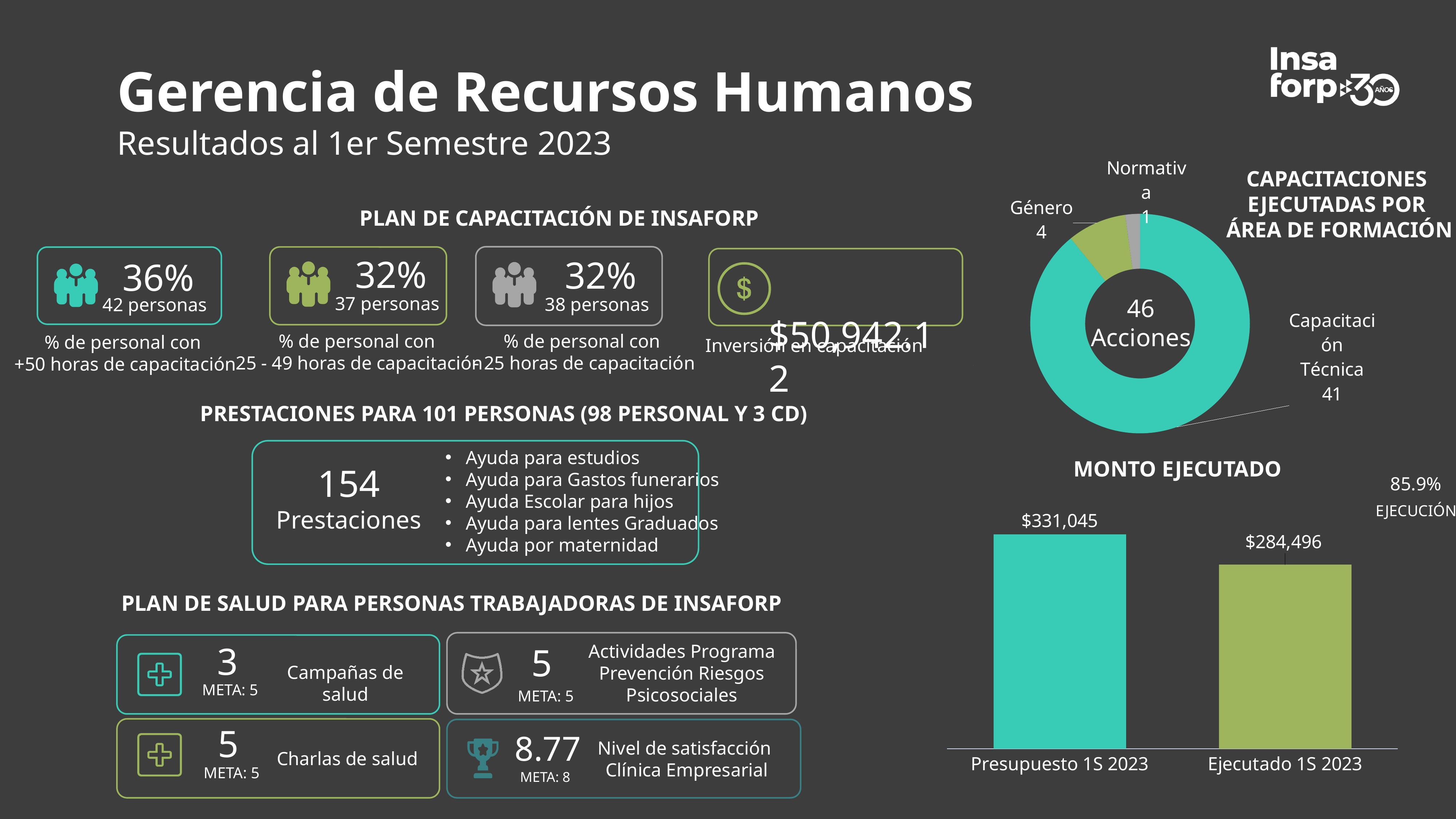
In the 'CAPACITACIONES EJECUTADAS POR ÁREA DE FORMACIÓN' chart, how many areas are shown? 3 What kind of chart is 'CAPACITACIONES EJECUTADAS POR ÁREA DE FORMACIÓN'? Donut (pie) chart In the 'MONTO EJECUTADO' chart, which is larger, Presupuesto 1S 2023 or Ejecutado 1S 2023? Presupuesto 1S 2023 In the 'MONTO EJECUTADO' chart, what is the value for Ejecutado 1S 2023? $284,496 In the 'CAPACITACIONES EJECUTADAS POR ÁREA DE FORMACIÓN' chart, which area has the most actions? Capacitación Técnica What kind of chart is 'MONTO EJECUTADO'? Bar chart In the 'CAPACITACIONES EJECUTADAS POR ÁREA DE FORMACIÓN' chart, which area has the fewest actions? Normativa In the 'CAPACITACIONES EJECUTADAS POR ÁREA DE FORMACIÓN' chart, how many actions are for Capacitación Técnica? 41 In the 'CAPACITACIONES EJECUTADAS POR ÁREA DE FORMACIÓN' chart, what is the total number of actions shown in the centre? 46 Acciones In the 'CAPACITACIONES EJECUTADAS POR ÁREA DE FORMACIÓN' chart, how many actions are for Género? 4 In the 'MONTO EJECUTADO' chart, what is the value for Presupuesto 1S 2023? $331,045 In the 'CAPACITACIONES EJECUTADAS POR ÁREA DE FORMACIÓN' chart, how many actions are for Normativa? 1